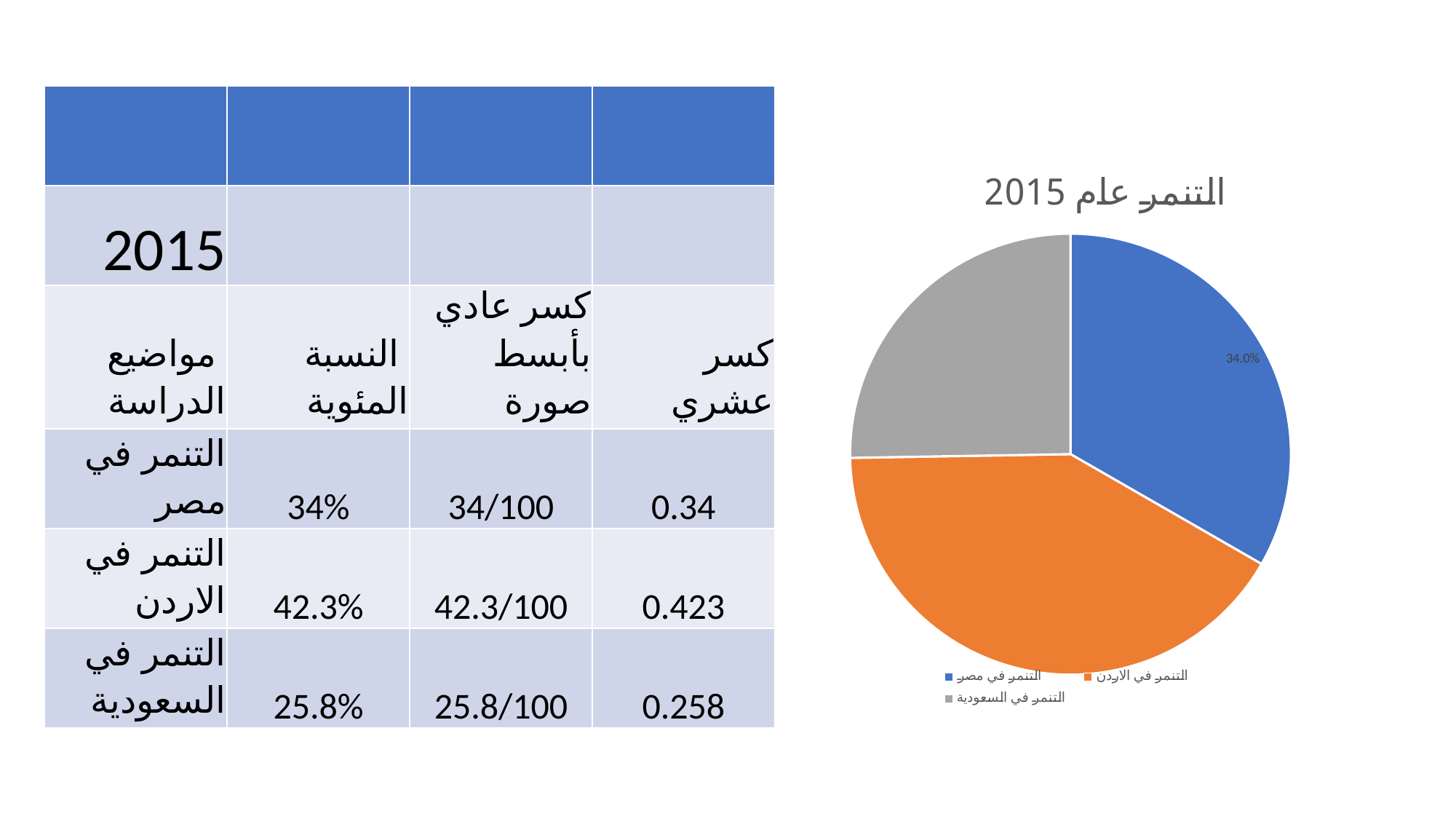
What percentage is printed on the slice for التنمر في مصر in the pie chart? 34.0% What kind of chart is shown on the slide? pie chart In the pie chart, which slice is larger: التنمر في الاردن or التنمر في مصر? التنمر في الاردن What is the title of the pie chart? التنمر عام 2015 Which category has the largest slice in the pie chart? التنمر في الاردن How many slices does the pie chart have? 3 In the pie chart, which slice is larger: التنمر في مصر or التنمر في السعودية? التنمر في مصر What share of the pie does التنمر في مصر take? 34.0% What colour is the slice for التنمر في مصر in the pie chart? blue Which category has the smallest slice in the pie chart? التنمر في السعودية How many entries does the pie chart's legend list? 3